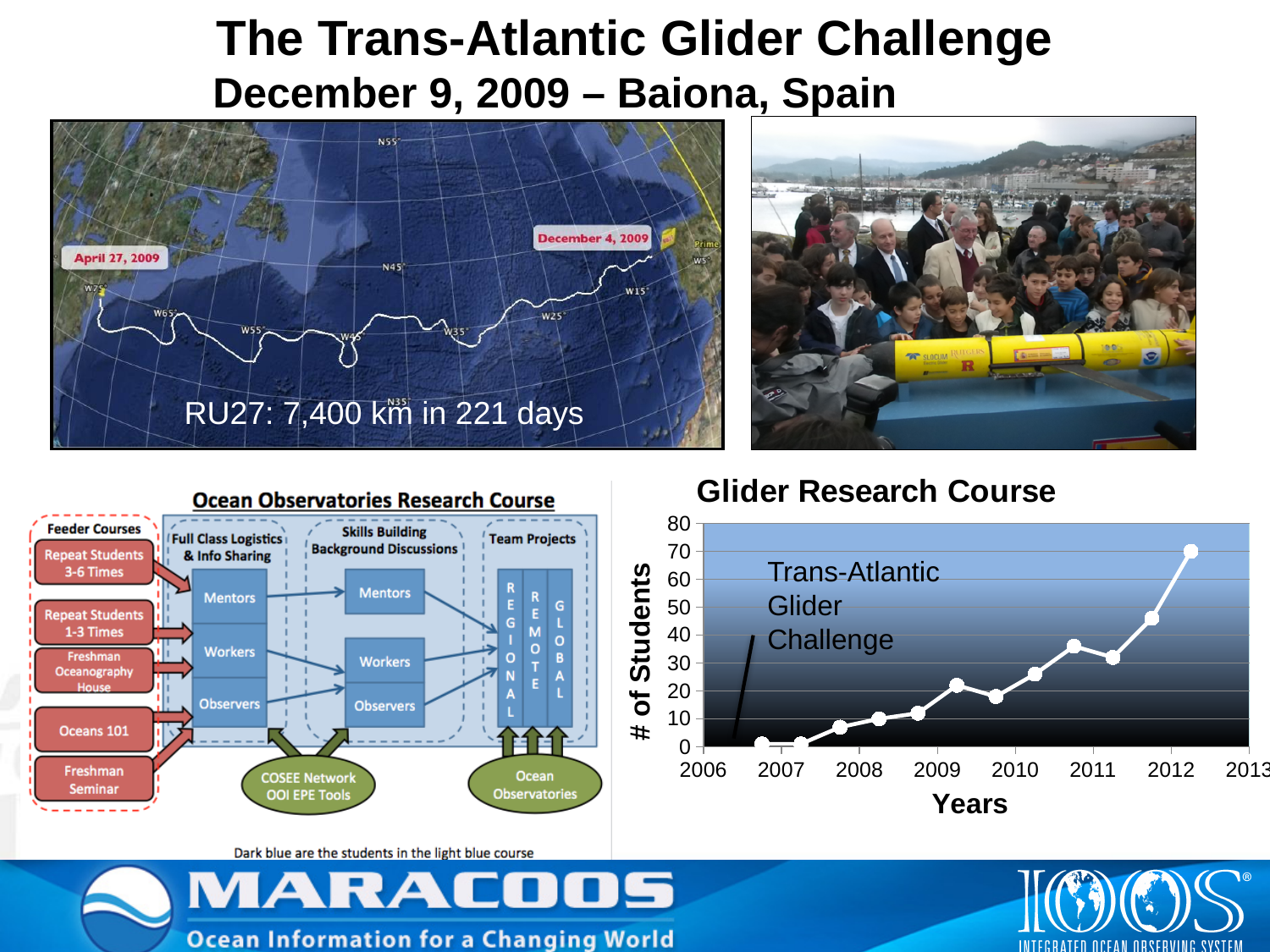
On the Glider Research Course chart, in which year does the line reach its highest value? 2012 On the Glider Research Course chart, is the value of the point at 2011 greater or less than 30? greater On the Glider Research Course chart, is the value of the first point near 2007 greater or less than 10? less On the Glider Research Course chart, is the value of the last (highest) point greater or less than 60? greater What is the title of the chart on the slide? Glider Research Course What kind of chart is the Glider Research Course chart? line chart What is the label of the vertical axis on the Glider Research Course chart? # of Students How many data points are plotted on the Glider Research Course chart? 12 On the Glider Research Course chart, which is larger: the value at 2012 or the value at 2008? 2012 Overall, do the values on the Glider Research Course chart rise or fall from 2007 to 2012? rise